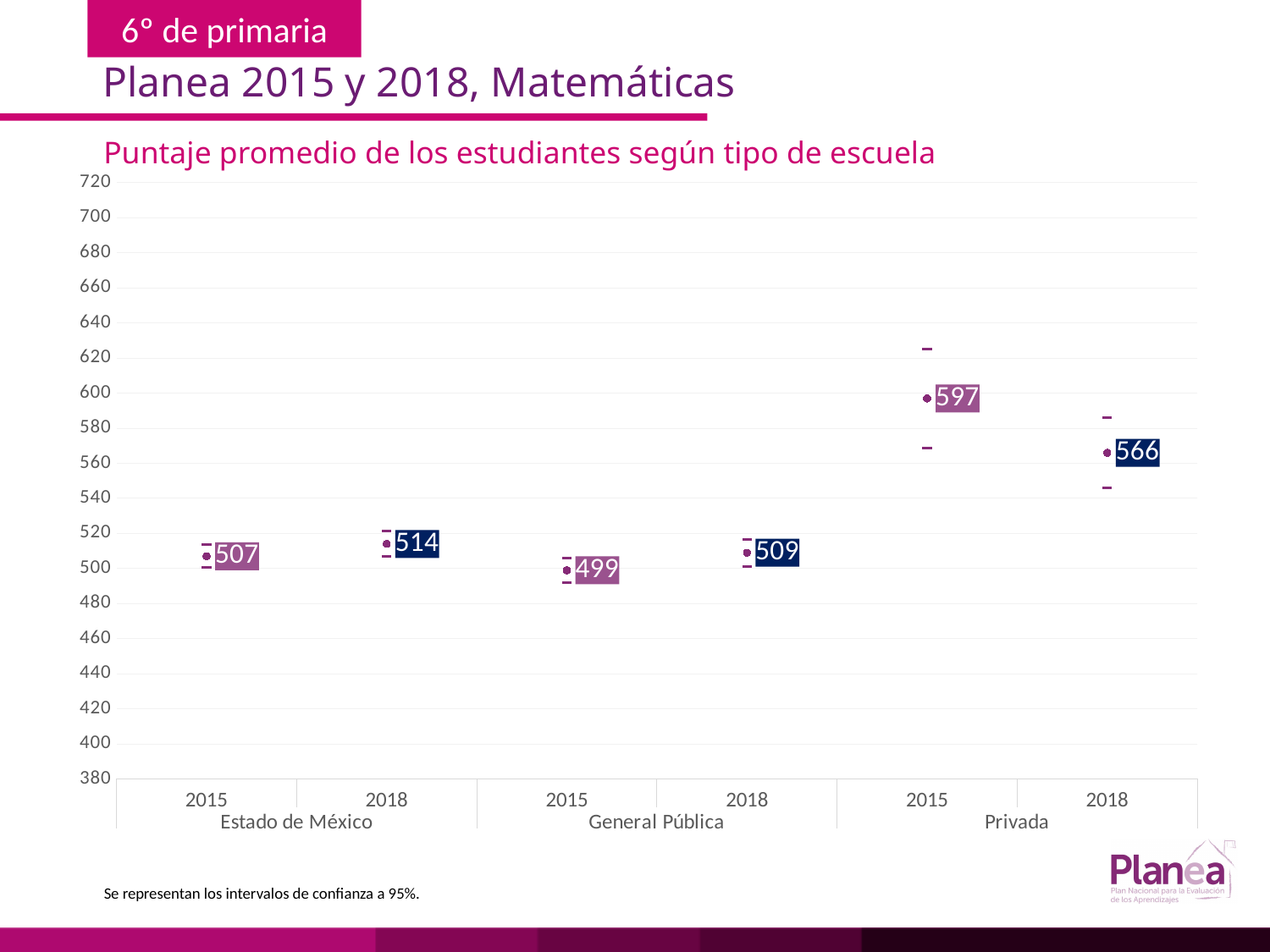
Which group and year has the lowest average score? General Pública 2015 What is the average score for General Pública in 2015? 499 Which group and year has the highest average score? Privada 2015 Which is larger, the Estado de México score in 2018 or the General Pública score in 2018? Estado de México 2018 What is the title of the chart? Puntaje promedio de los estudiantes según tipo de escuela How many data points are plotted on the chart? 6 What is the average score for Estado de México in 2015? 507 By how much did the General Pública score change from 2015 to 2018? 10 What is the average score for Privada in 2018? 566 Did the Privada score rise or fall from 2015 to 2018? fall Is the Privada score in 2015 greater or less than 580? greater What is the difference between the Privada scores in 2015 and 2018? 31